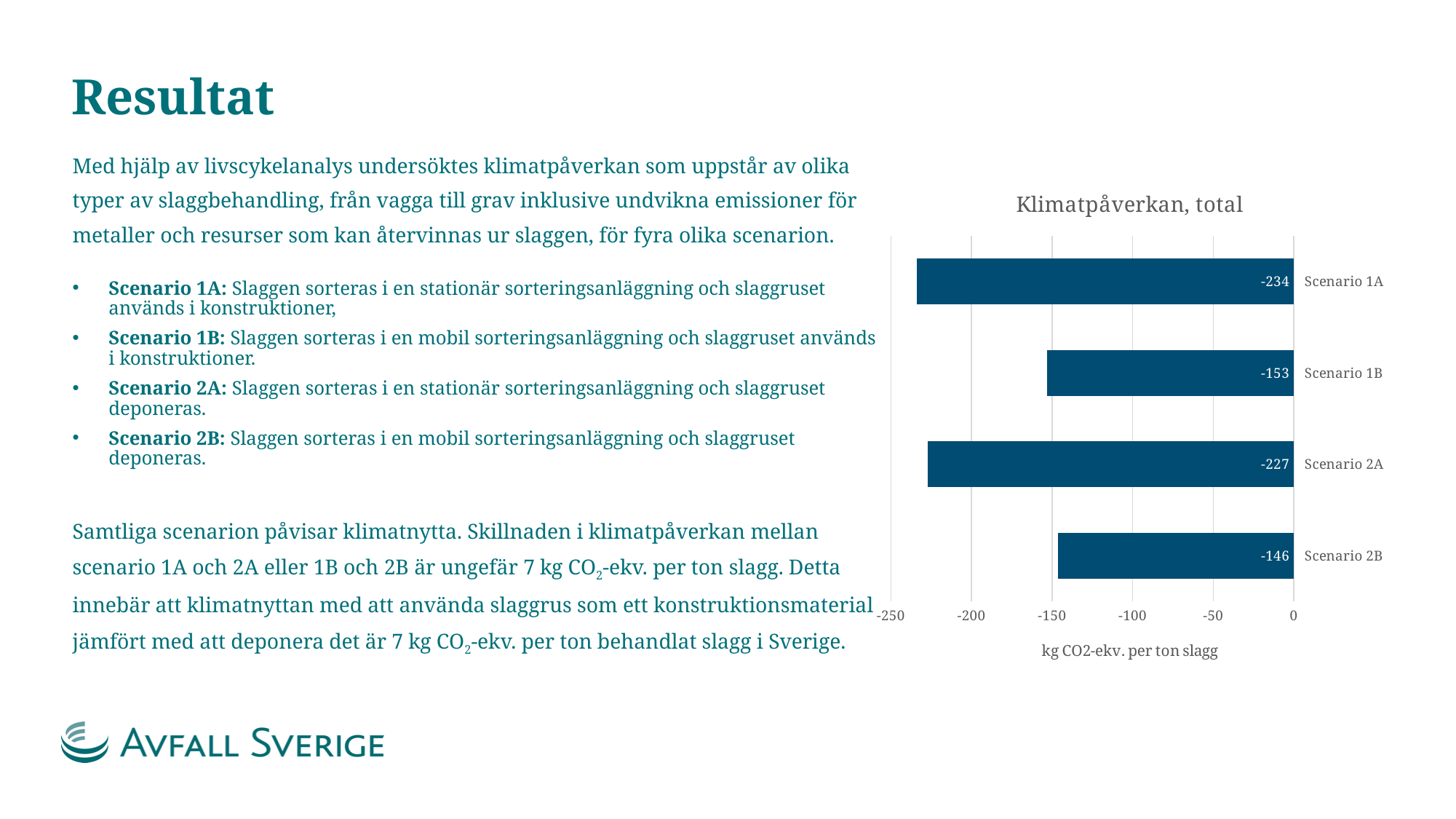
What is the difference between the values for Scenario 1A and Scenario 2A? 7 What is the difference between the values for Scenario 1B and Scenario 2B? 7 How many scenarios are shown in the chart? 4 What is the value for Scenario 1A in the chart? -234 Which scenario has the highest (least negative) value in the chart? Scenario 2B Which scenario has the lowest (most negative) value in the chart? Scenario 1A What is the value for Scenario 1B in the chart? -153 What kind of chart is shown on the slide? Bar chart Which bar is longer, Scenario 1B or Scenario 2A? Scenario 2A What is the title of the chart? Klimatpåverkan, total What is the value for Scenario 2A in the chart? -227 What is the value for Scenario 2B in the chart? -146